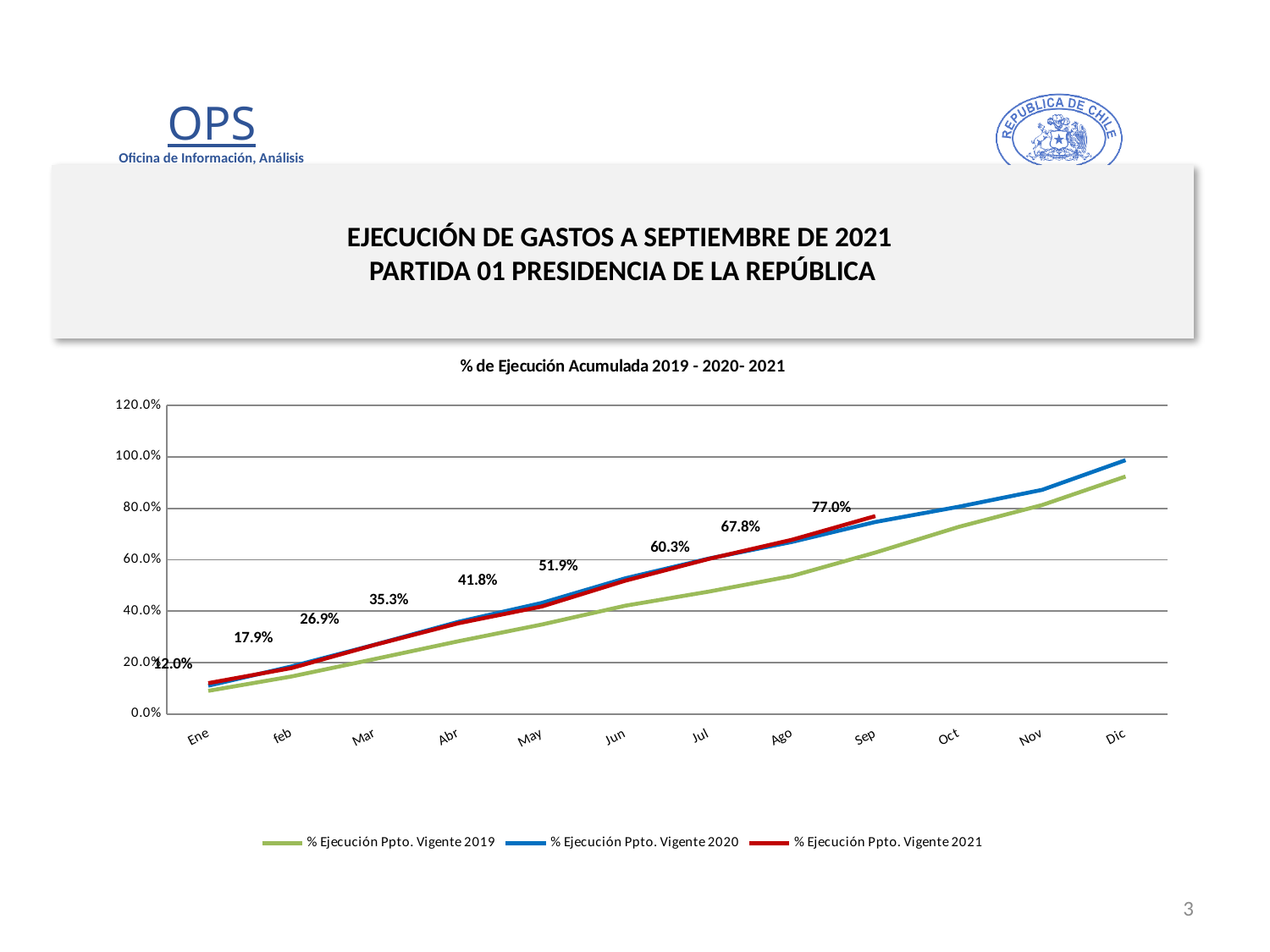
In which month does the % Ejecución Ppto. Vigente 2021 series have its lowest labelled value? Ene What is the value of the % Ejecución Ppto. Vigente 2021 series in Jun? 51.9% Is the value of the % Ejecución Ppto. Vigente 2019 series in Dic greater or less than 100.0%? less How many series does the legend list? 3 What is the value of the % Ejecución Ppto. Vigente 2021 series in Mar? 26.9% What is the difference between the 2021 values for Sep and Ago? 9.2% Which is larger for the 2021 series: the value in Jul or the value in Abr? Jul In which month does the % Ejecución Ppto. Vigente 2021 series reach its highest labelled value? Sep How many months are shown on the x axis? 12 What is the value of the % Ejecución Ppto. Vigente 2021 series in Sep? 77.0% Is the value of the % Ejecución Ppto. Vigente 2020 series in Nov greater or less than 80.0%? greater What kind of chart is shown on the slide? Line chart